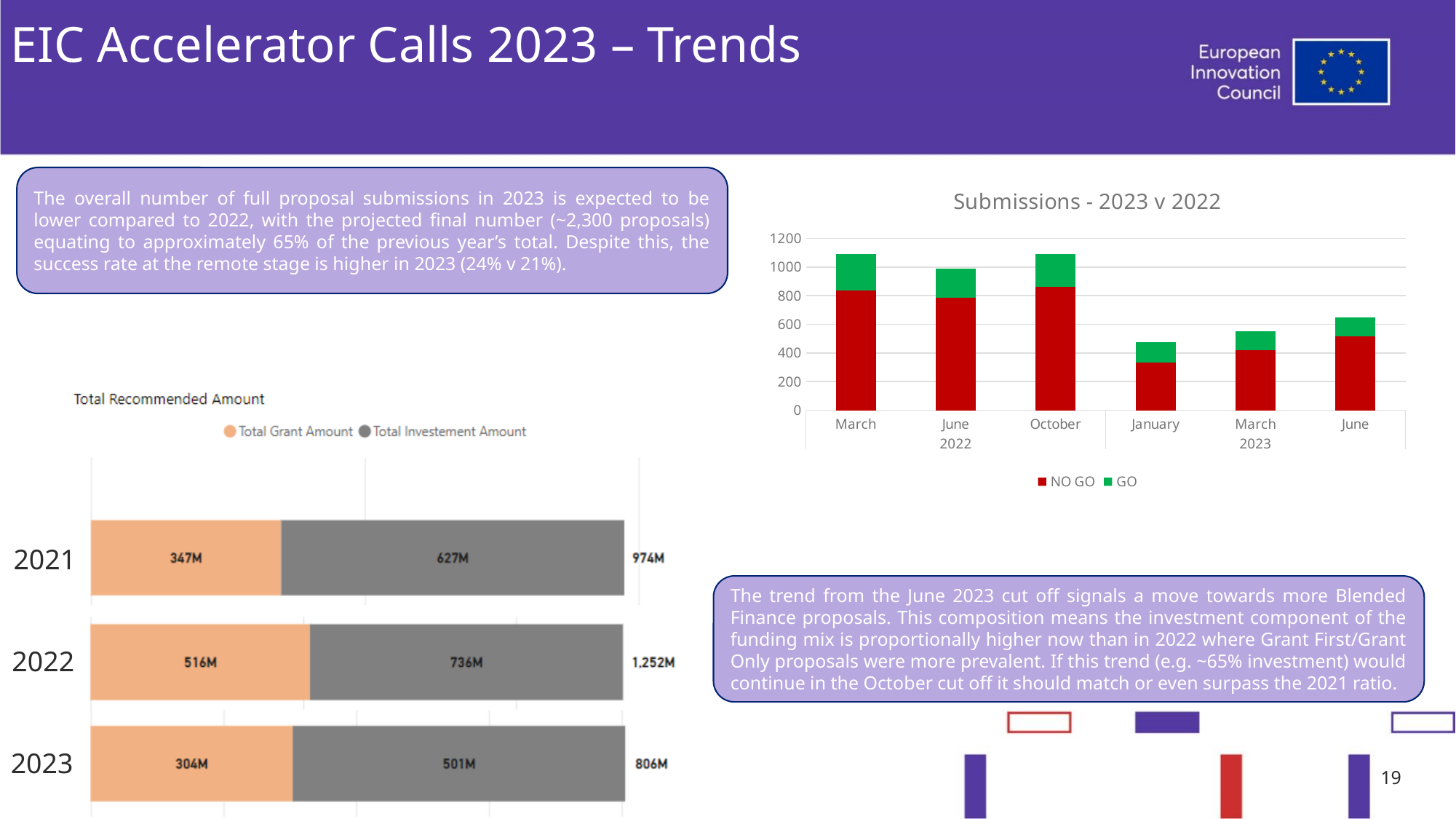
In the 'Total Recommended Amount' chart, which year has the highest total recommended amount? 2022 In the 'Total Recommended Amount' chart, is the Total Grant Amount for 2021 larger or smaller than the Total Grant Amount for 2023? larger In the 'Submissions - 2023 v 2022' chart, is the total for January 2023 greater or less than 600? less How many bars are shown in the 'Submissions - 2023 v 2022' chart? 6 In the 'Total Recommended Amount' chart, what is the Total Investment Amount for 2023? 501M In the 'Total Recommended Amount' chart, what is the Total Grant Amount for 2022? 516M What kind of chart is the 'Submissions - 2023 v 2022' chart? stacked bar chart How many series does the legend of the 'Total Recommended Amount' chart list? 2 In the 'Total Recommended Amount' chart, which year has the lowest Total Grant Amount? 2023 In the 'Total Recommended Amount' chart, what is the difference between the Total Investment Amount for 2022 and 2021? 109M In the 'Total Recommended Amount' chart, what is the total recommended amount for 2021? 974M In the 'Submissions - 2023 v 2022' chart, is the NO GO value for October 2022 greater or less than 800? greater